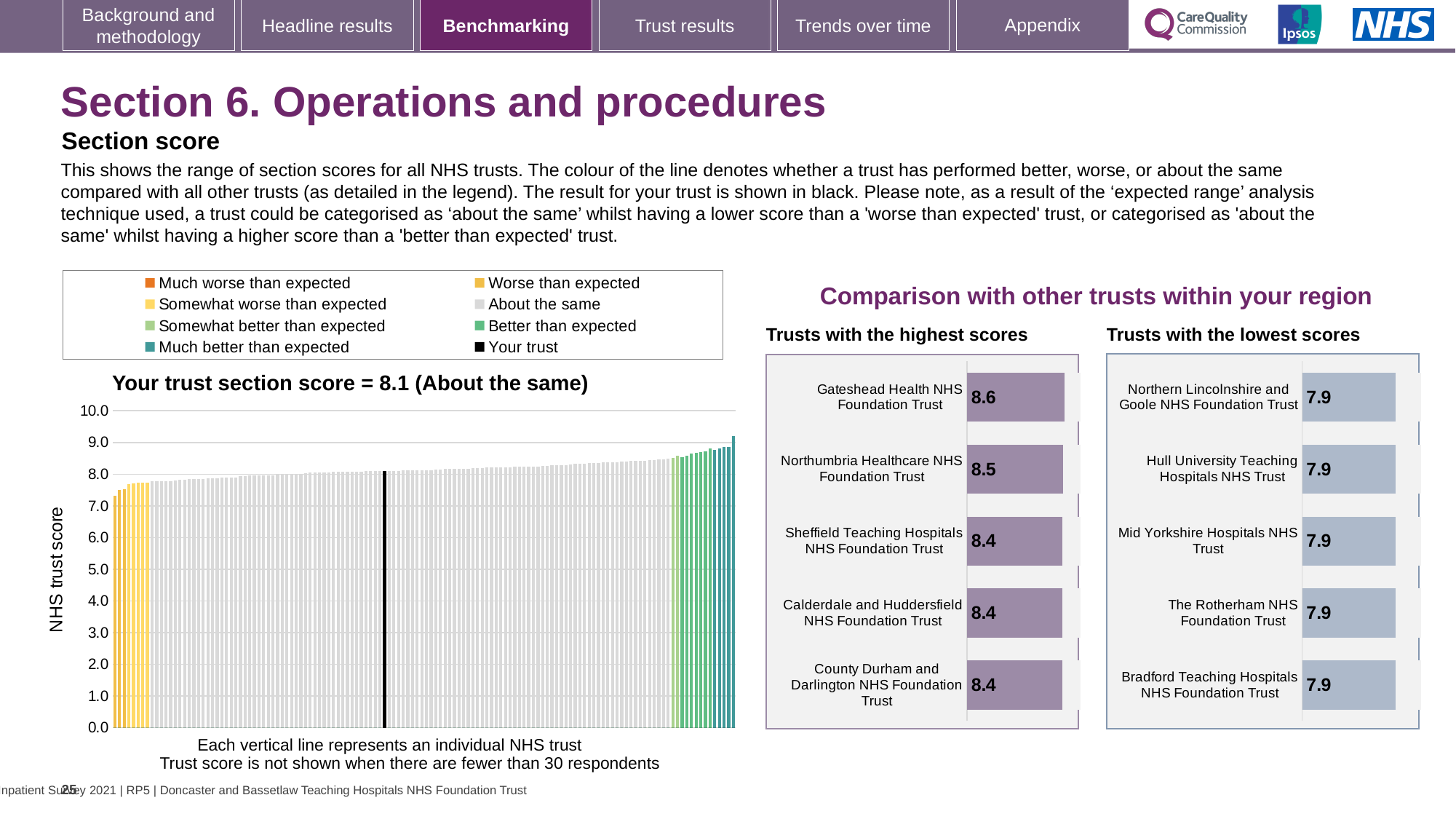
In the 'Trusts with the lowest scores' chart, what is the score for Mid Yorkshire Hospitals NHS Trust? 7.9 In the 'Trusts with the highest scores' chart, what is the difference between the scores of Gateshead Health NHS Foundation Trust and Northumbria Healthcare NHS Foundation Trust? 0.1 In the 'Your trust section score' chart, do the trust scores rise or fall from left to right? rise In the 'Trusts with the highest scores' chart, which trust has the highest score? Gateshead Health NHS Foundation Trust In the 'Your trust section score' chart, what is the section score for your trust? 8.1 In the 'Trusts with the highest scores' chart, how many trusts are shown? 5 In the 'Trusts with the lowest scores' chart, how many trusts are shown? 5 How many entries does the legend above the 'Your trust section score' chart list? 8 Which is larger: the score for Sheffield Teaching Hospitals NHS Foundation Trust in the 'Trusts with the highest scores' chart or the score for The Rotherham NHS Foundation Trust in the 'Trusts with the lowest scores' chart? Sheffield Teaching Hospitals NHS Foundation Trust In the 'Trusts with the highest scores' chart, what is the score for Gateshead Health NHS Foundation Trust? 8.6 In the 'Your trust section score' chart, what is the label on the vertical axis? NHS trust score In the 'Your trust section score' chart, what kind of chart is used to show the range of trust scores? bar chart